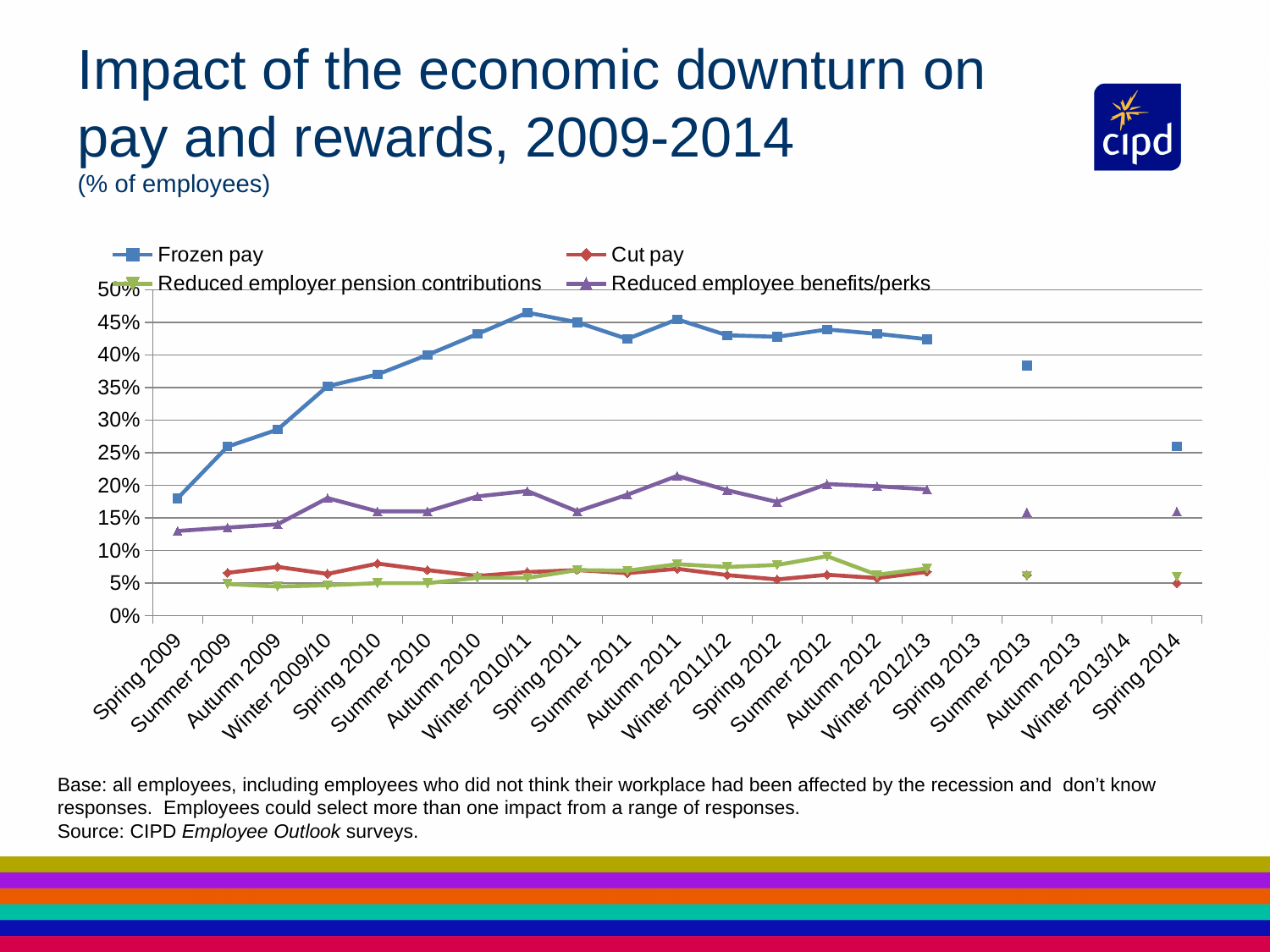
Which is larger in Spring 2011, Frozen pay or Cut pay? Frozen pay Does the Frozen pay line rise or fall from Spring 2009 to Winter 2009/10? rise Which series has the highest values across the whole period? Frozen pay Is the value for Cut pay in Spring 2014 greater or less than 10%? less Is the value for Frozen pay in Spring 2009 greater or less than 20%? less What kind of chart is shown on the slide? line chart How many series does the legend list? 4 Is the value for Reduced employee benefits/perks in Autumn 2011 greater or less than 20%? greater How many time periods are shown along the x axis? 21 What colour is the Frozen pay line in the legend? blue In which period is the Frozen pay value lowest? Spring 2009